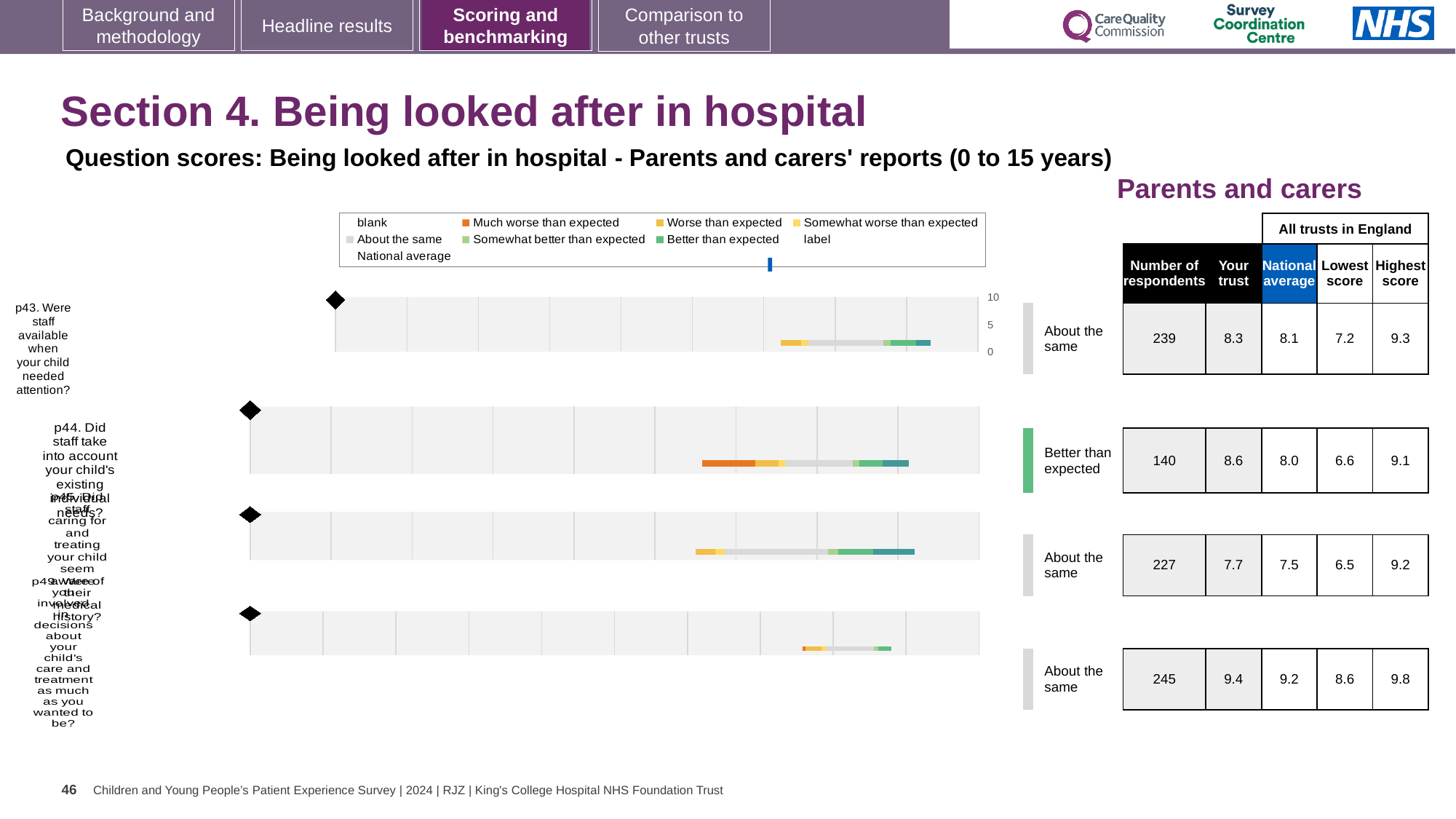
What is the national average score for p43 (Were staff available when your child needed attention?)? 8.1 Which of the four question rows has the highest 'Your trust' score? The fourth row (p49), 9.4 What is the highest score among all trusts in England for the fourth row (p49)? 9.8 How many question rows (charts) are shown on the slide? 4 Which of the four question rows has the lowest 'Your trust' score? The third row (p45), 7.7 For the first chart row (p43, Were staff available when your child needed attention?), how many respondents are shown? 239 What is the 'Your trust' score for p43 (Were staff available when your child needed attention?)? 8.3 What is the lowest score among all trusts in England for the first row (p43)? 7.2 What benchmark category is shown for the second row (p44)? Better than expected What kind of chart is used for each question row? Bar chart For the second row (p44), what is the difference between the 'Your trust' score and the national average? 0.6 For the third row (p45), which is larger: the 'Your trust' score or the national average? Your trust (7.7)